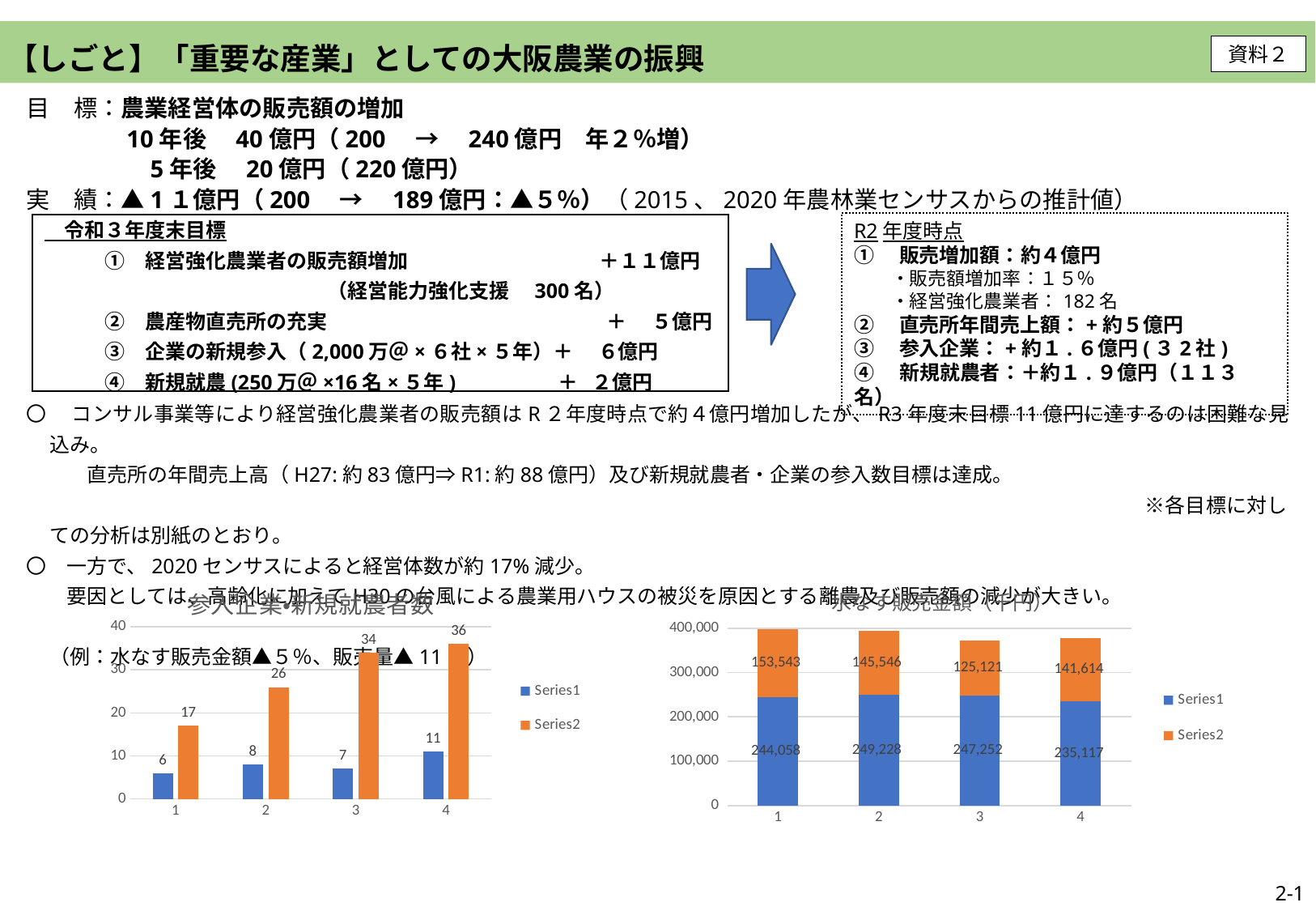
In the left chart, which category has the highest Series2 value? 4 In the left chart, what is the value of Series2 for category 4? 36 In the right chart, what is the value of Series2 for category 3? 125,121 In the right chart, which category has the lowest Series2 value? 3 In the left chart, does Series2 rise or fall from category 1 to category 4? rise How many series does the legend of the right chart list? 2 In the right chart, what is the value of Series1 for category 4? 235,117 In the right chart, what is the total of the stacked bar for category 1? 397,601 What kind of chart is the left chart? bar chart In the left chart, which category has the lowest Series1 value? 1 In the left chart, what is the value of Series1 for category 2? 8 In the left chart, what is the difference between Series2 and Series1 for category 3? 27